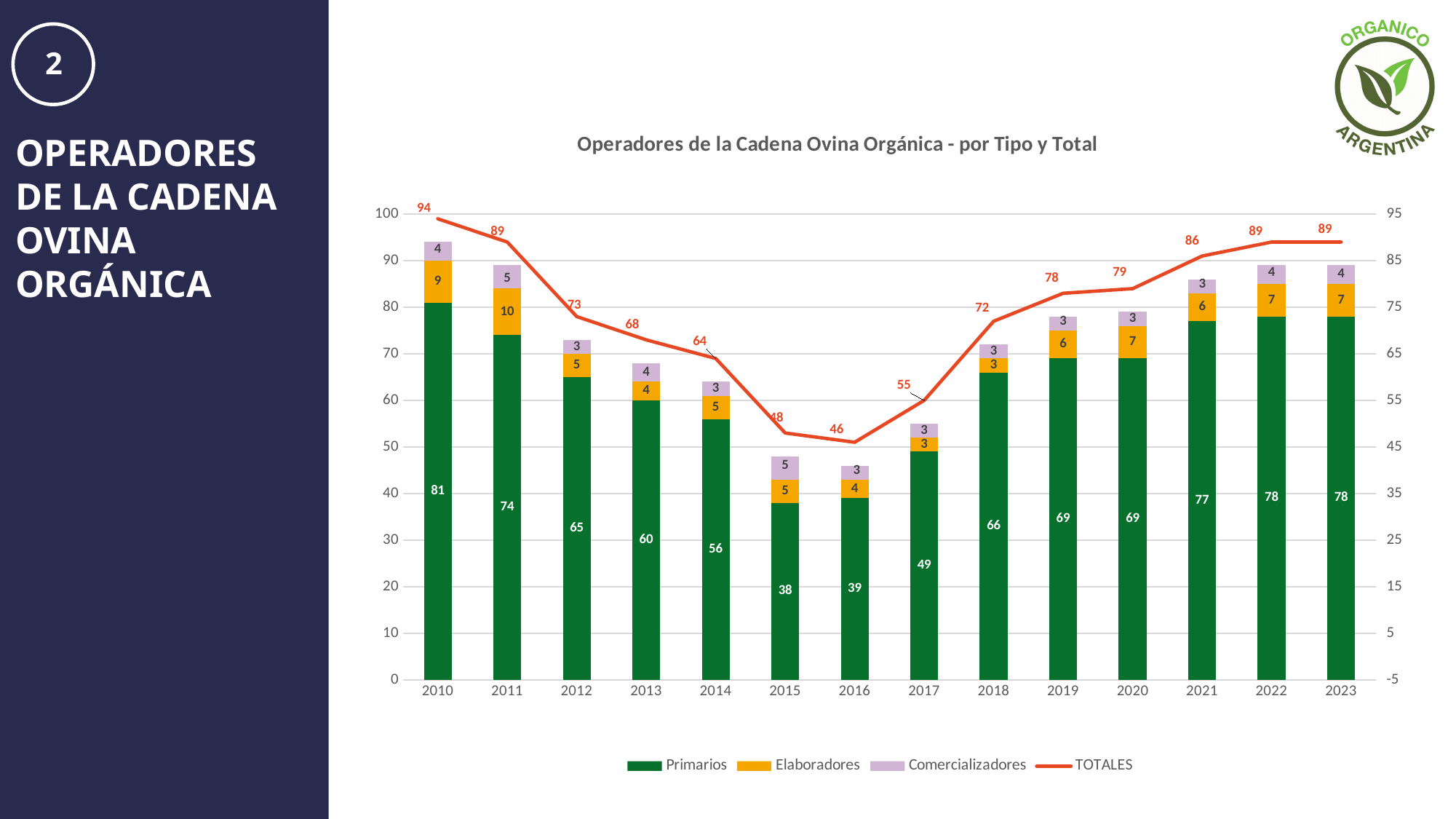
Which is larger, the Primarios value in 2021 or in 2018? 2021 In which year is the TOTALES value highest? 2010 How many years are shown on the x axis? 14 What is the value for Primarios in 2010? 81 What is the difference between the TOTALES values for 2010 and 2016? 48 What is the value for Elaboradores in 2011? 10 What is the TOTALES value for 2016? 46 What kind of chart is this? Stacked bar chart with a line Does the TOTALES line rise or fall from 2017 to 2023? Rise What is the value for Comercializadores in 2015? 5 How many series does the legend list? 4 In which year is the Primarios value lowest? 2015